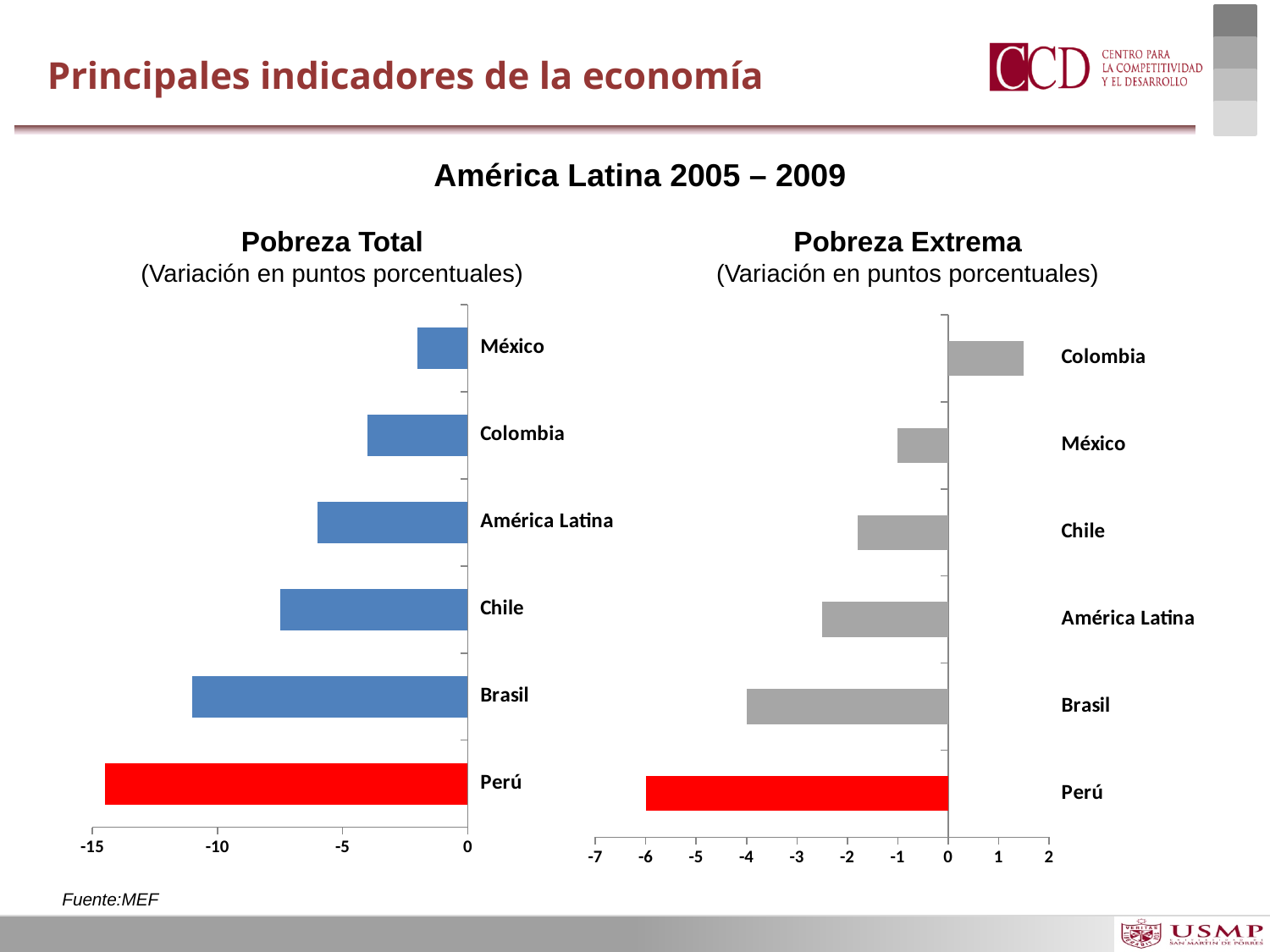
In the Pobreza Extrema chart, is the value for Perú greater or less than -5? less In the Pobreza Total chart, is the value for Chile greater or less than -5? less In the Pobreza Total chart, is the value for México greater or less than -5? greater In the Pobreza Total chart, which category has the highest value (closest to zero)? México In the Pobreza Extrema chart, which category has the highest value? Colombia What kind of chart is the Pobreza Total chart? bar chart In the Pobreza Extrema chart, which is lower, Brasil or Chile? Brasil In the Pobreza Total chart, which category has the lowest (most negative) value? Perú How many countries or regions are shown in the Pobreza Extrema chart? 6 In the Pobreza Total chart, which category's bar is coloured red? Perú